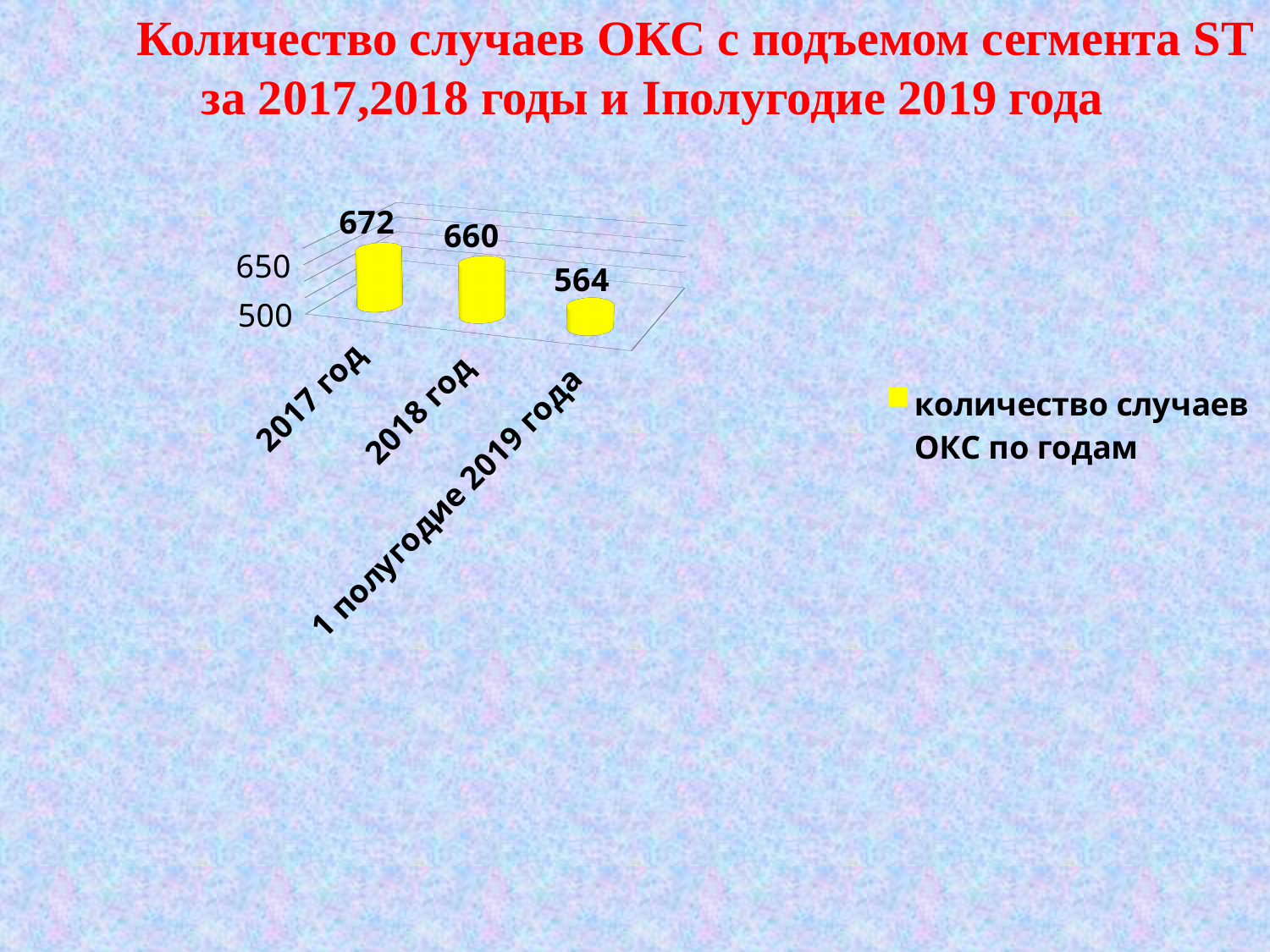
What is the value for 2018 год? 660 What is the value for 1 полугодие 2019 года? 564 What is the difference between the values for 2018 год and 1 полугодие 2019 года? 96 How many categories are shown on the chart? 3 Which category has the lowest value? 1 полугодие 2019 года Is the value for 1 полугодие 2019 года greater or less than 650? less Which is larger, the value for 2017 год or the value for 1 полугодие 2019 года? 2017 год What is the difference between the values for 2017 год and 2018 год? 12 What is the value for 2017 год? 672 Which category has the highest value? 2017 год What kind of chart is shown on the slide? bar chart Do the values rise or fall from 2017 год to 1 полугодие 2019 года? fall